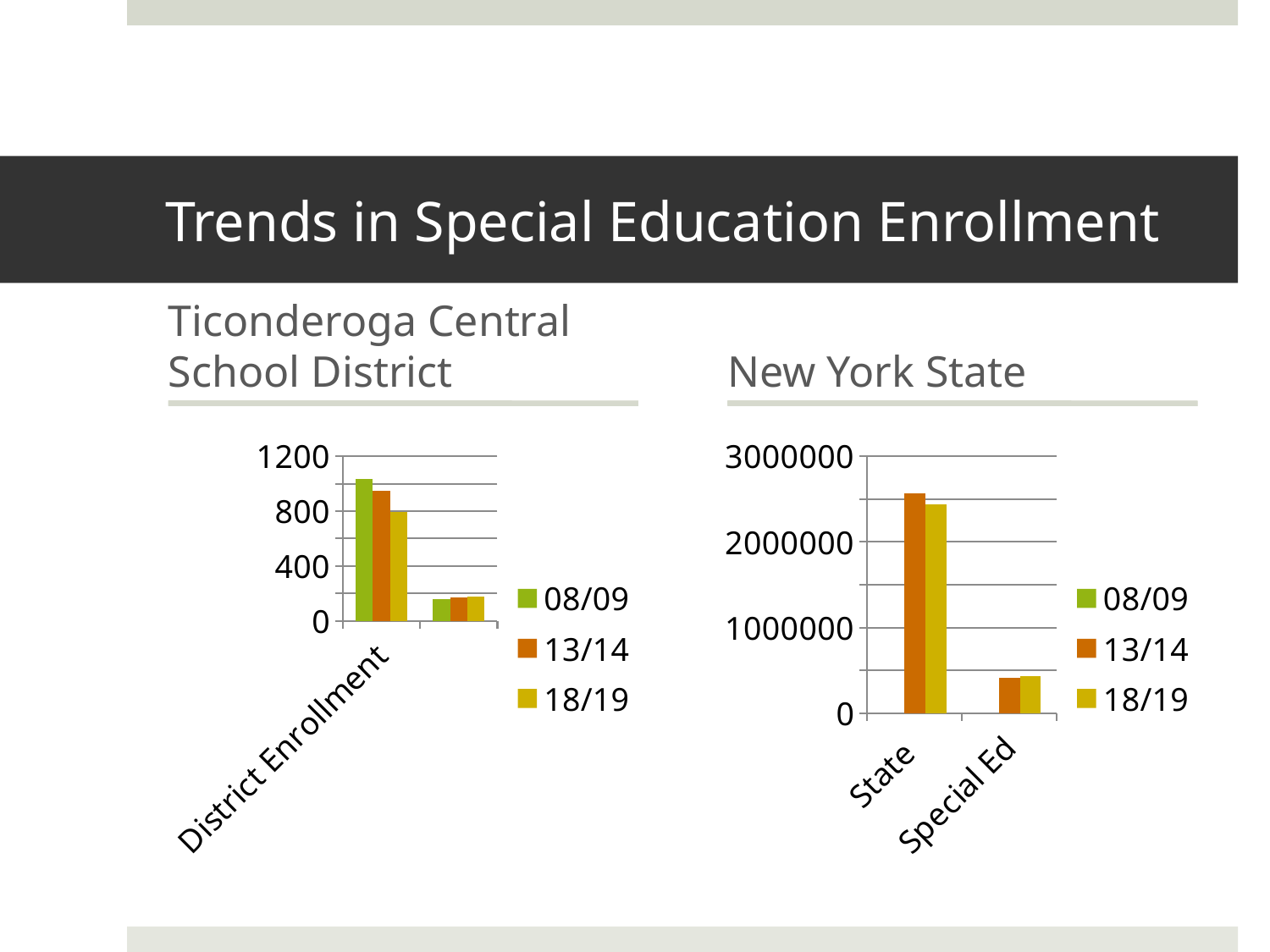
What kind of chart is the Ticonderoga Central School District chart? bar chart In the New York State chart, which series has the higher value for State: 13/14 or 18/19? 13/14 In the Ticonderoga Central School District chart, is the 13/14 value for District Enrollment greater or less than 1200? less In the Ticonderoga Central School District chart, do the District Enrollment values rise or fall from 08/09 to 18/19? fall In the Ticonderoga Central School District chart, which series has the highest District Enrollment value? 08/09 In the Ticonderoga Central School District chart, is the 08/09 value for District Enrollment greater or less than 800? greater What is the title of the chart on the right side of the slide? New York State In the New York State chart, is the 18/19 value for Special Ed greater or less than 1000000? less How many series does the legend of the New York State chart list? 3 In the New York State chart, which is larger for 13/14: State or Special Ed? State How many categories are shown on the x axis of the New York State chart? 2